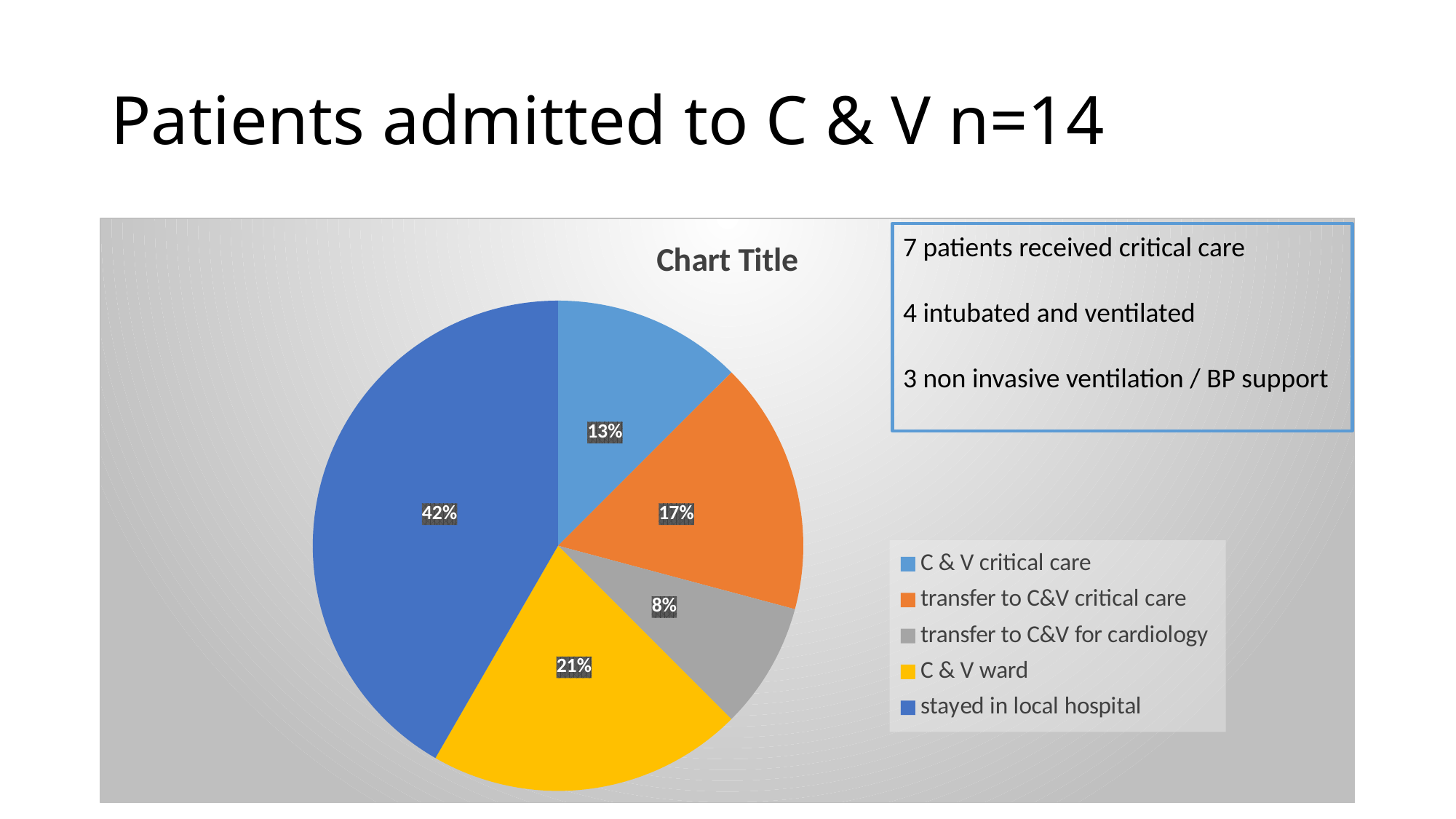
What colour is the slice for 'C & V ward'? yellow What share of the pie is 'transfer to C&V for cardiology'? 8% Which is larger, the share for 'transfer to C&V critical care' or the share for 'C & V critical care'? transfer to C&V critical care What is the difference in percentage points between 'stayed in local hospital' and 'C & V ward'? 21 What share of the pie is 'C & V ward'? 21% Which category has the largest slice of the pie? stayed in local hospital What share of the pie is 'transfer to C&V critical care'? 17% How many categories does the pie chart show? 5 Which category has the smallest slice of the pie? transfer to C&V for cardiology What kind of chart is shown on the slide? pie chart